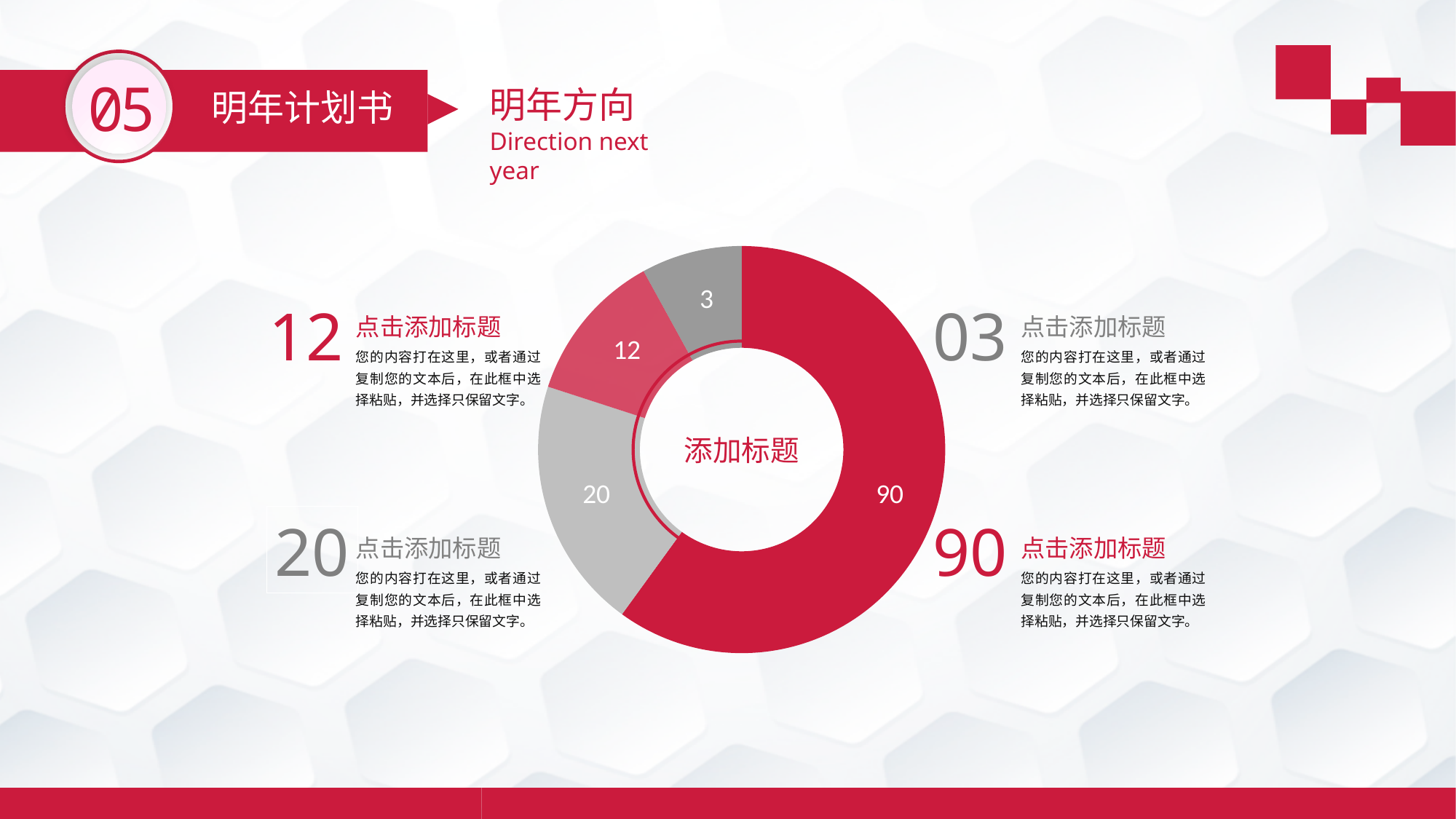
What value is shown on the large dark red slice of the donut chart? 90 Which is larger, the light gray slice or the pink slice? The light gray slice (20) What kind of chart is shown on the slide? Donut chart What value is shown on the light gray slice of the donut chart? 20 What is the total of all slice values in the donut chart? 125 What is the value of the smallest slice in the donut chart? 3 What is the value of the largest slice in the donut chart? 90 What is the difference between the slice labeled 12 and the slice labeled 3? 9 What text appears in the center of the donut chart? 添加标题 What is the difference between the largest slice (90) and the slice labeled 20? 70 How many slices does the donut chart have? 4 What value is shown on the pink slice of the donut chart? 12